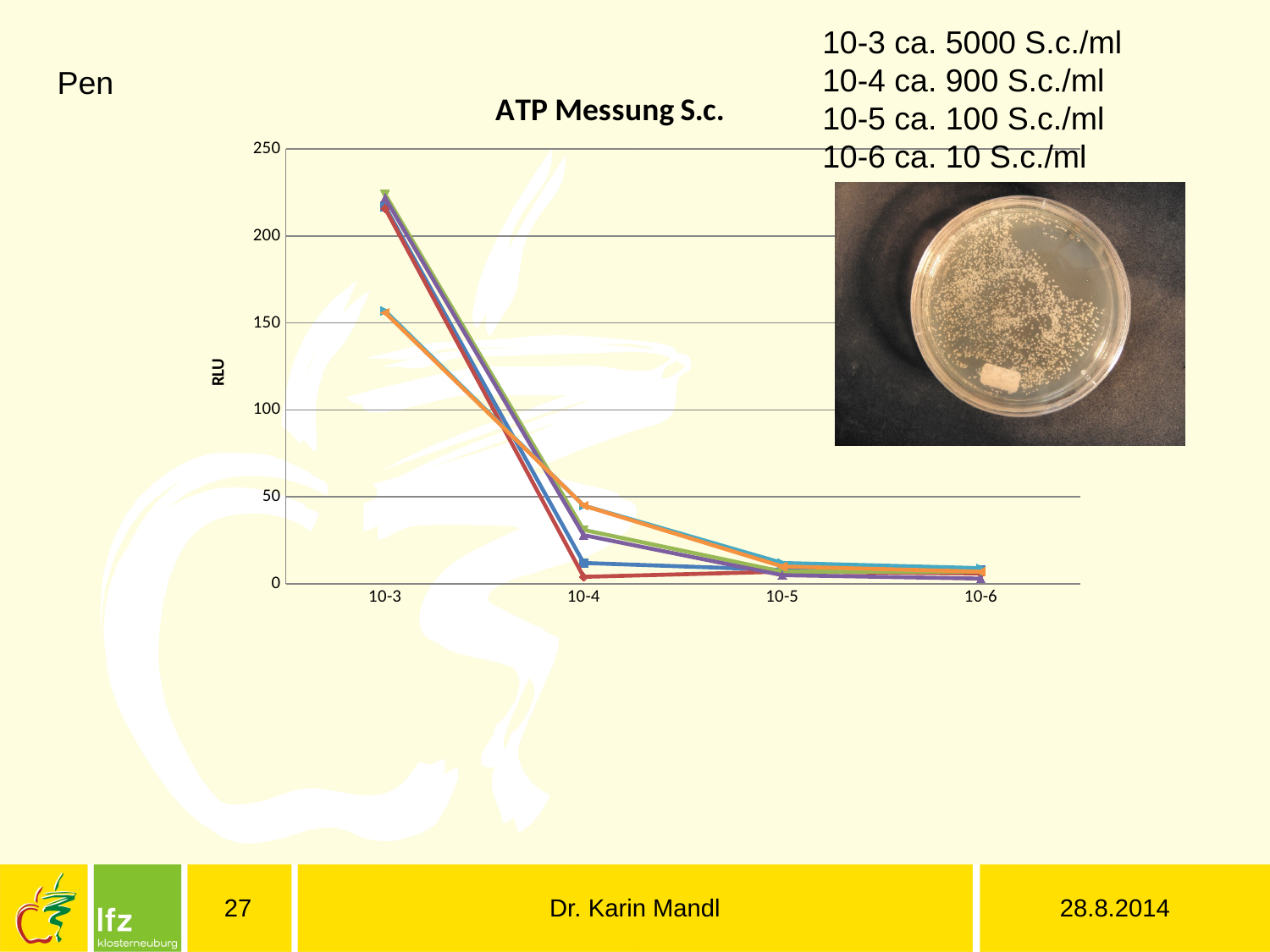
Which x-axis category has the highest values for all lines? 10-3 Do the plotted values rise or fall from 10-3 to 10-6 along the x-axis? fall What is the maximum value shown on the y-axis of the chart? 250 What is the title of the chart? ATP Messung S.c. Are the values of all lines at 10-6 greater or less than 50? less Are the values of the highest lines at 10-3 greater or less than 200? greater What is the label of the y-axis of the chart? RLU Are the values at 10-3 larger or smaller than the values at 10-5? larger Is the value of the lowest line at 10-3 greater or less than 100? greater What type of chart is shown on the slide? line chart How many categories are shown on the x-axis of the chart? 4